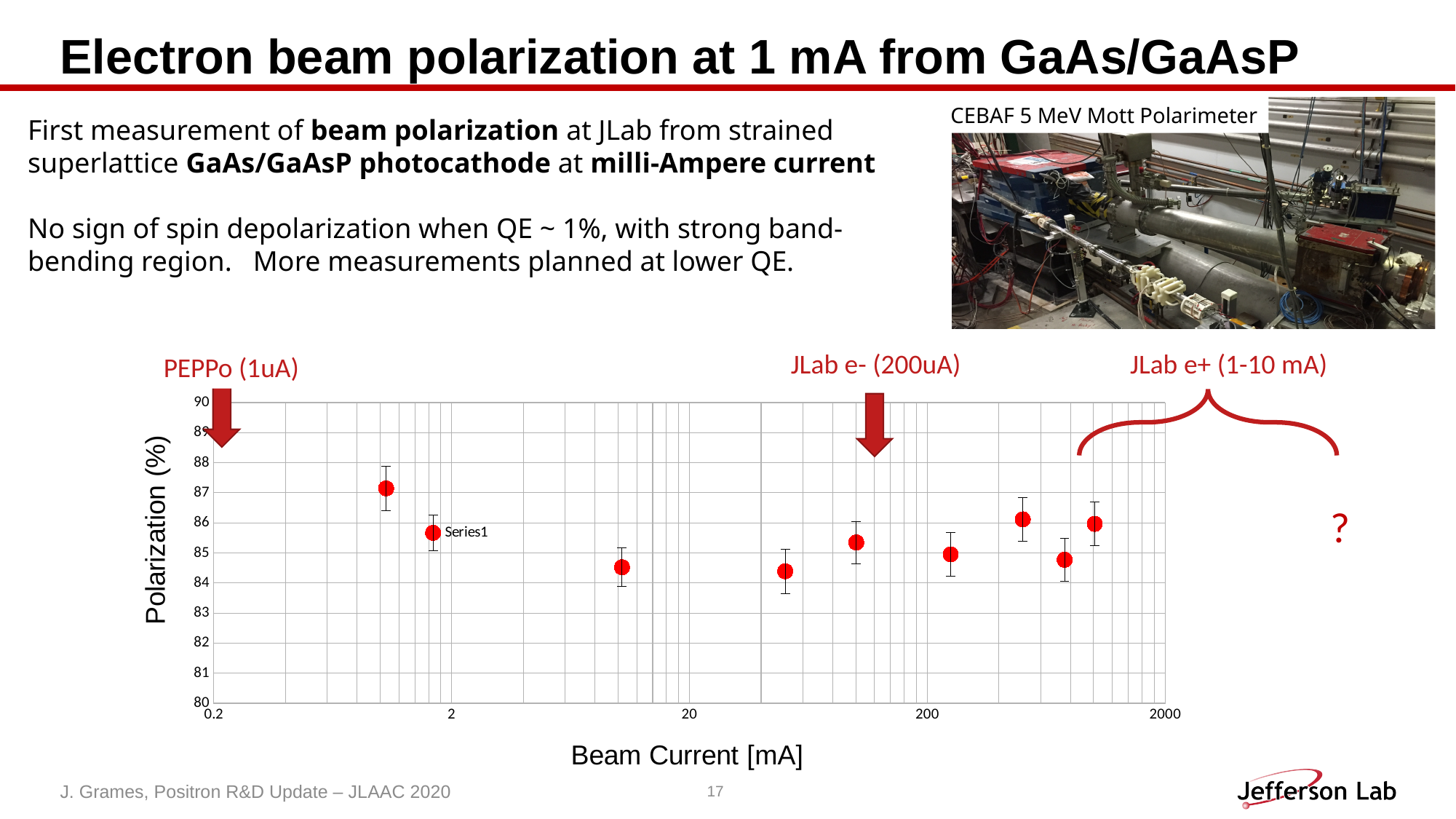
Is the polarization of the lowest data point greater or less than 85? less What is the title of the y axis of the chart? Polarization (%) Is the polarization of the highest data point greater or less than 86? greater How many data points are plotted in the chart? 9 What is the largest tick value shown on the x axis of the chart? 2000 What is the highest value shown on the y axis of the chart? 90 What is the title of the x axis of the chart? Beam Current [mA] What is the lowest value shown on the y axis of the chart? 80 Do the polarization values show a strong rising or falling trend with beam current, or stay roughly flat? Roughly flat Which data point has the highest polarization: the leftmost point (near 1 mA) or the rightmost point (near 1000 mA)? The leftmost point (near 1 mA) What kind of chart is shown on the slide? Scatter chart Are all plotted polarization values greater or less than 88? less